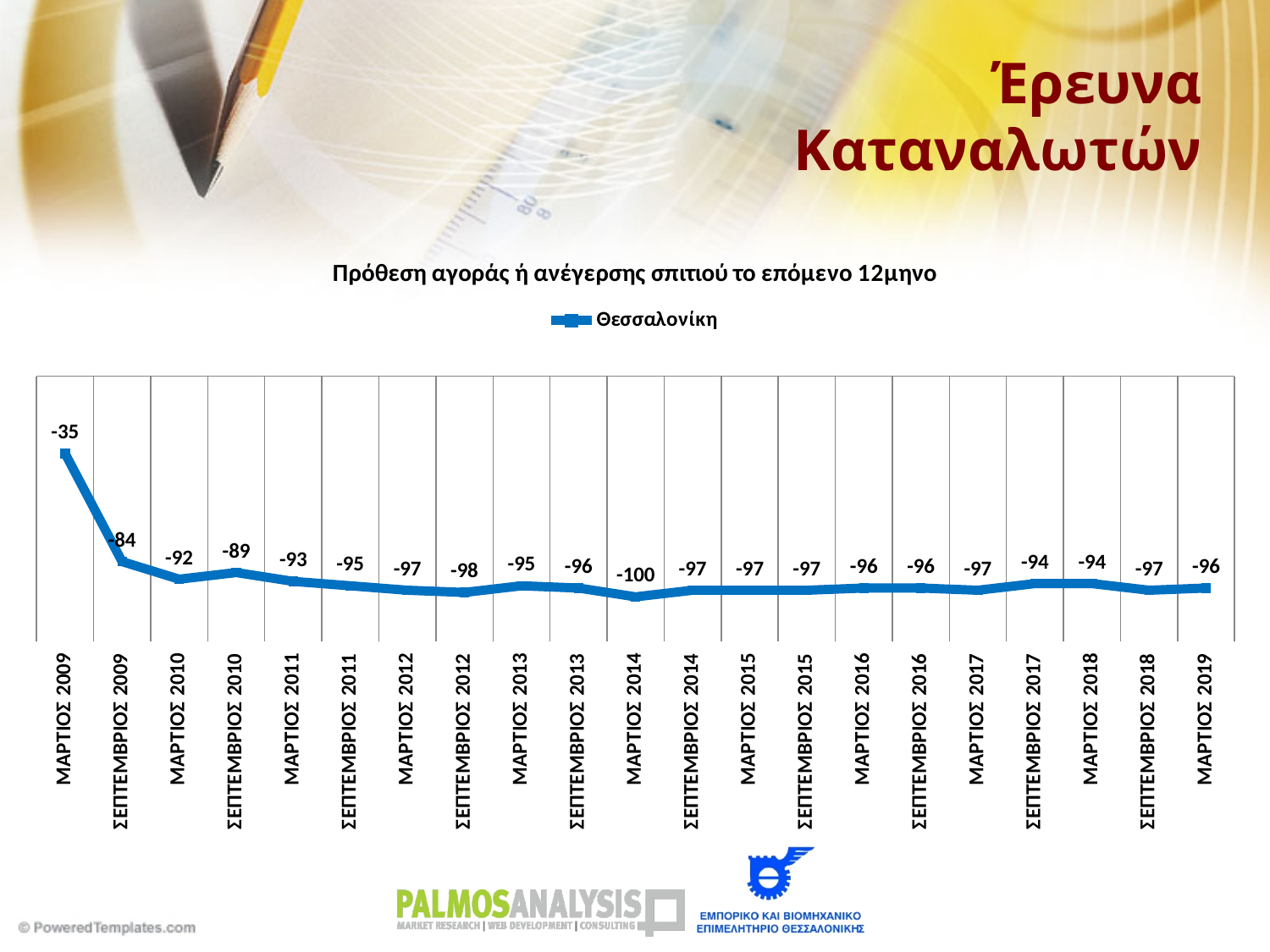
How many data points are plotted on the chart? 21 What type of chart is shown on the slide? line chart What is the value for ΜΑΡΤΙΟΣ 2014? -100 What is the name of the series shown in the legend? Θεσσαλονίκη What is the value for ΜΑΡΤΙΟΣ 2009? -35 Which period has the highest value? ΜΑΡΤΙΟΣ 2009 What is the value for ΜΑΡΤΙΟΣ 2019? -96 How many series does the legend list? 1 Which period has the lowest value? ΜΑΡΤΙΟΣ 2014 What is the value for ΣΕΠΤΕΜΒΡΙΟΣ 2010? -89 What is the difference between the values for ΜΑΡΤΙΟΣ 2009 and ΣΕΠΤΕΜΒΡΙΟΣ 2009? 49 Which is larger, the value for ΣΕΠΤΕΜΒΡΙΟΣ 2017 or the value for ΣΕΠΤΕΜΒΡΙΟΣ 2018? ΣΕΠΤΕΜΒΡΙΟΣ 2017